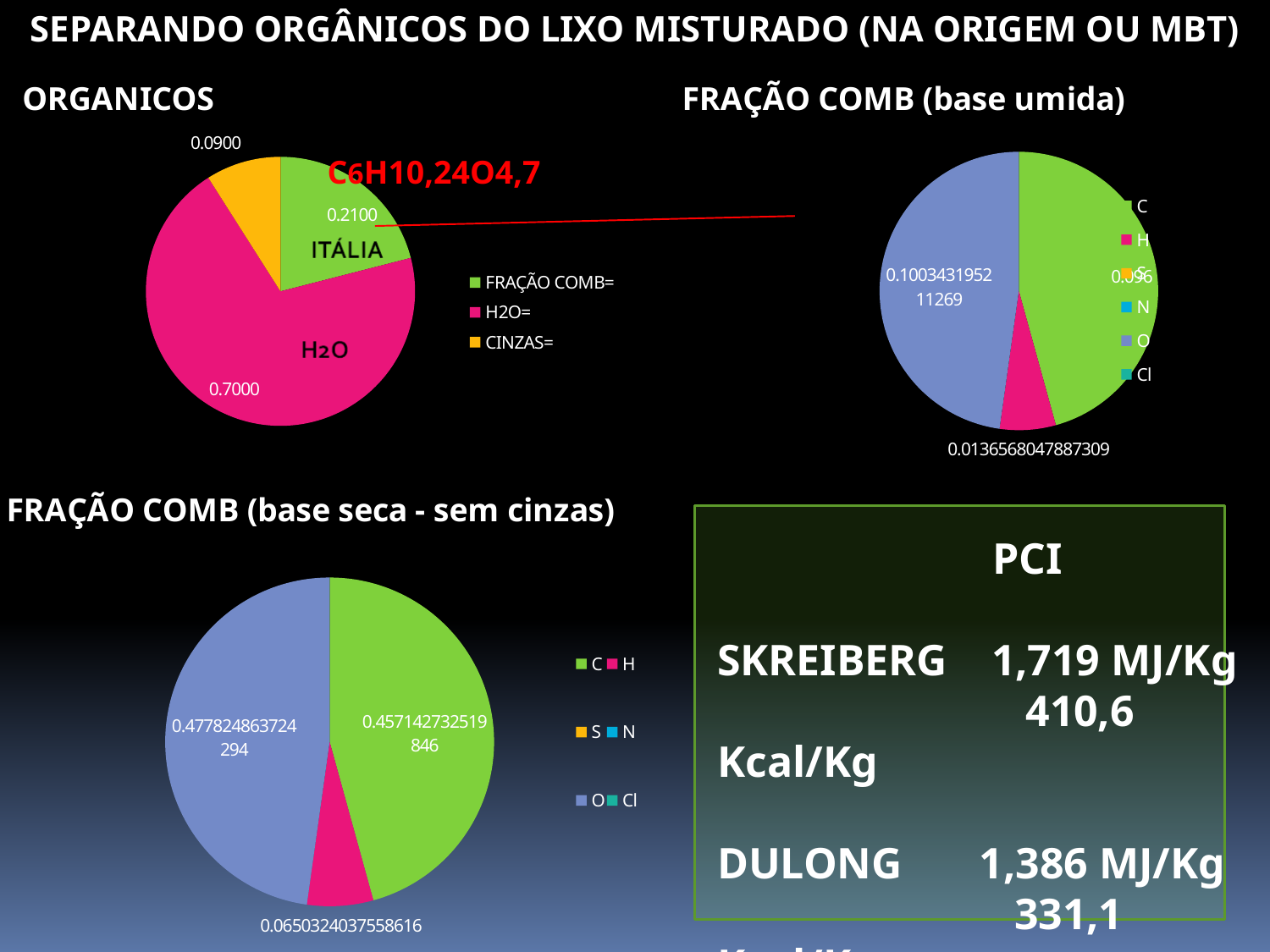
In the ORGANICOS pie chart, which category has the largest slice? H2O= What type of chart is used for FRAÇÃO COMB (base umida)? Pie chart In the ORGANICOS pie chart, what is the value shown for CINZAS=? 0.0900 In the FRAÇÃO COMB (base umida) pie chart, what value is shown for the H slice? 0.0136568047887309 In the ORGANICOS pie chart, what is the value shown for FRAÇÃO COMB=? 0.2100 How many entries does the legend of the ORGANICOS chart list? 3 In the ORGANICOS pie chart, which category has the smallest slice? CINZAS= In the ORGANICOS pie chart, what is the value shown for H2O=? 0.7000 In the FRAÇÃO COMB (base seca - sem cinzas) pie chart, what value is shown for the H slice? 0.0650324037558616 In the FRAÇÃO COMB (base seca - sem cinzas) pie chart, which is larger, the C slice or the O slice? O In the ORGANICOS pie chart, what is the difference between the H2O= value and the FRAÇÃO COMB= value? 0.4900 In the FRAÇÃO COMB (base umida) pie chart, what value is shown for the O slice? 0.100343195211269